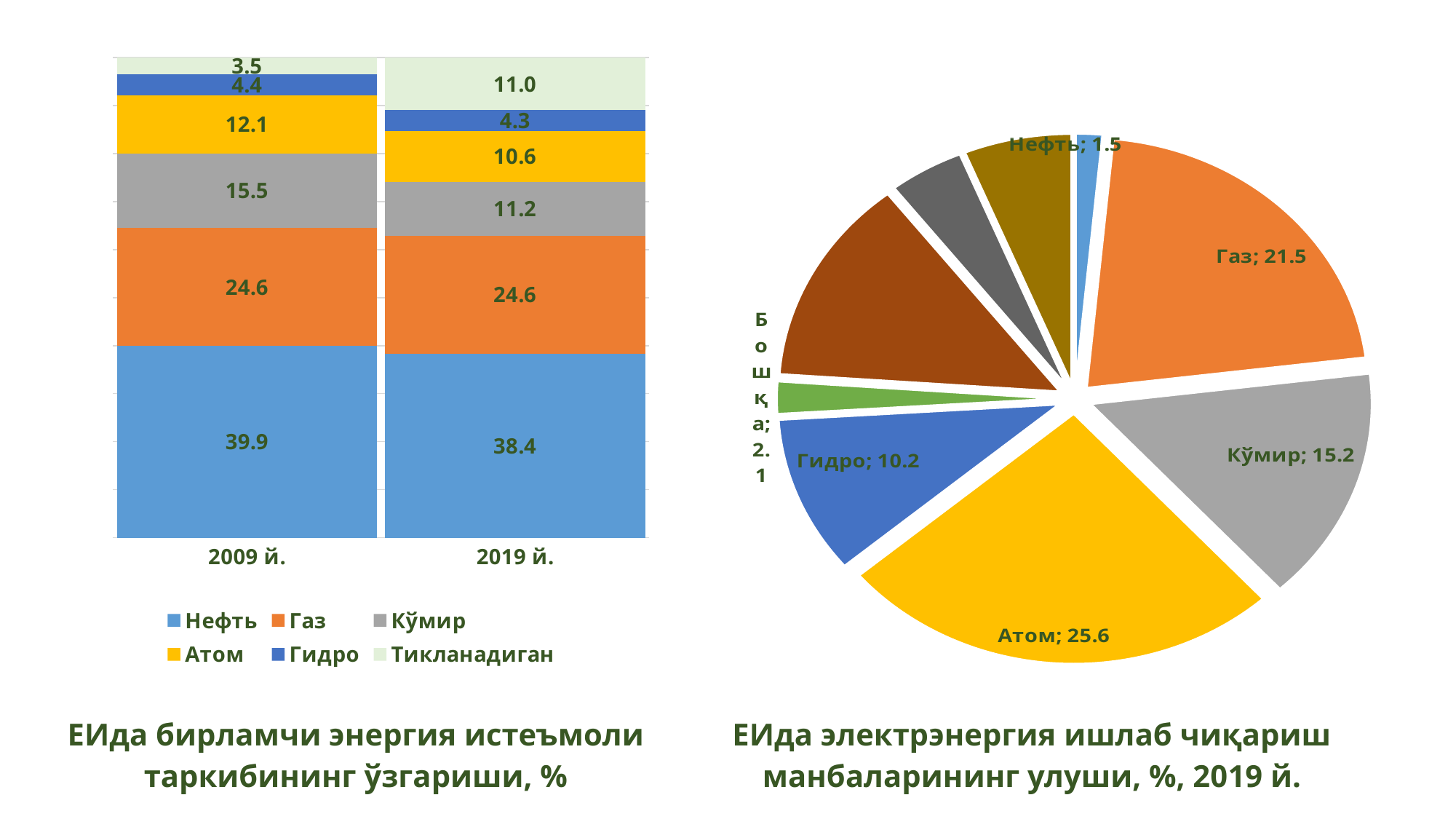
What type of chart is the chart on the right side of the slide? Pie chart In the left stacked bar chart, by how much did the Кўмир value change from 2009 й. to 2019 й.? 4.3 In the left stacked bar chart, what is the value for Кўмир in 2019 й.? 11.2 In the left stacked bar chart, is the Атом value larger in 2009 й. or in 2019 й.? 2009 й. In the left stacked bar chart, what is the value for Нефть in 2009 й.? 39.9 How many series does the legend of the left stacked bar chart list? 6 In the right pie chart, which labeled slice is the largest? Атом In the right pie chart, what is the value for Атом? 25.6 In the left stacked bar chart, which segment is the largest in the 2019 й. bar? Нефть In the left stacked bar chart, which segment is the smallest in the 2009 й. bar? Тикланадиган In the right pie chart, what is the difference between the Газ and Гидро values? 11.3 In the left stacked bar chart, what is the value for Тикланадиган in 2019 й.? 11.0